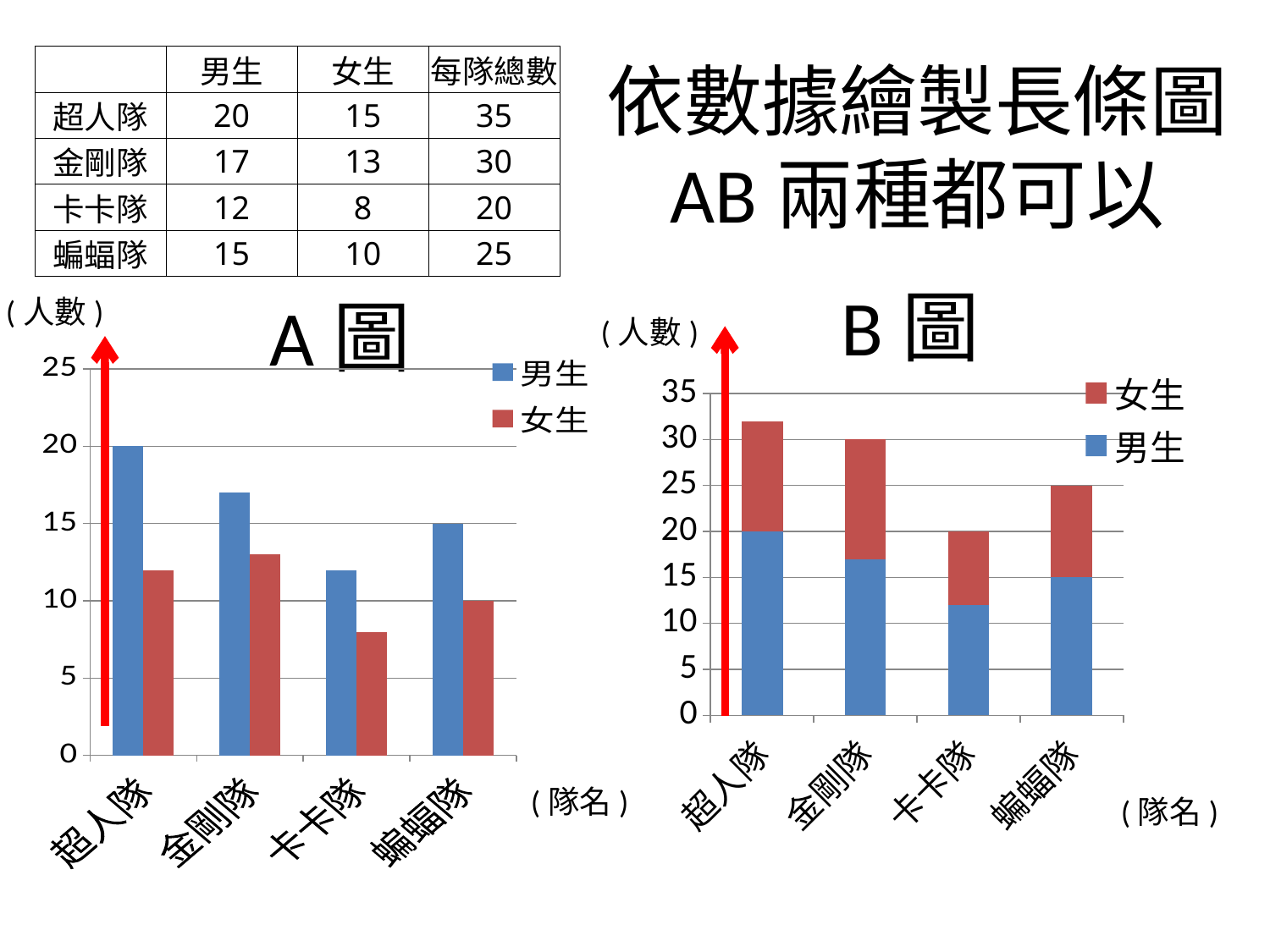
In A 圖, is the 女生 value for 金剛隊 greater or less than 15? less In A 圖, how many teams are shown on the x axis? 4 In B 圖, is the stacked bar for 超人隊 taller than the stacked bar for 蝙蝠隊? Yes In B 圖, how many series does the legend list? 2 In B 圖, which team has the shortest stacked bar? 卡卡隊 What kind of chart is B 圖? stacked bar chart What kind of chart is A 圖? bar chart In B 圖, what is the total height of the stacked bar for 金剛隊? 30 In A 圖, which team has the lowest 女生 bar? 卡卡隊 In A 圖, what is the value of 男生 for 超人隊? 20 In A 圖, which team has the highest 男生 bar? 超人隊 In A 圖, what is the value of 女生 for 蝙蝠隊? 10